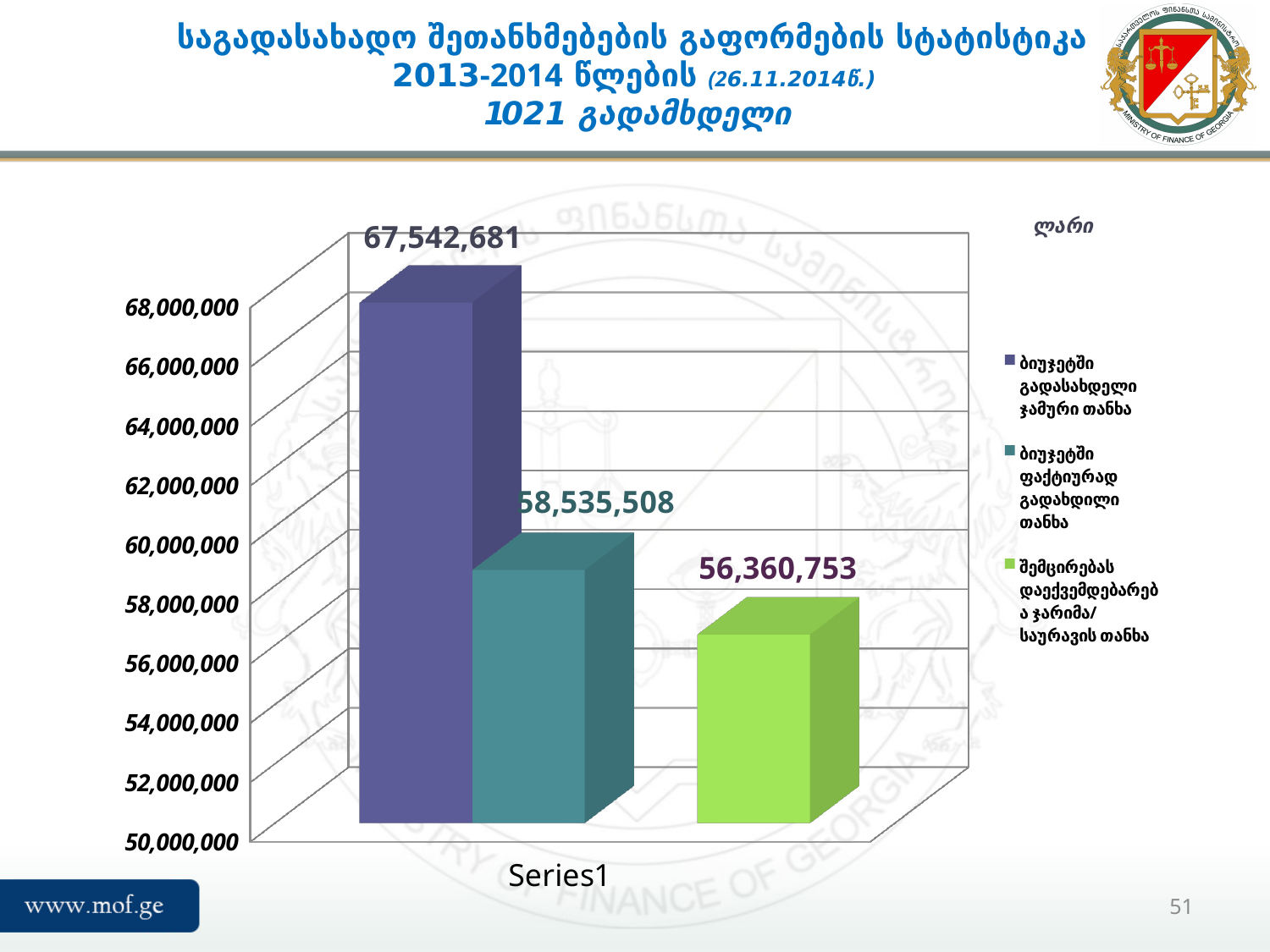
What type of chart is shown on the slide? bar chart What is the value of the bar for ბიუჯეტში გადასახდელი ჯამური თანხა? 67,542,681 What is the value of the bar for ბიუჯეტში ფაქტიურად გადახდილი თანხა? 58,535,508 How many bars are plotted in the chart? 3 How many series does the legend list? 3 Which series has the lowest value in the chart? შემცირებას დაექვემდებარება ჯარიმა/საურავის თანხა Which series has the highest value in the chart? ბიუჯეტში გადასახდელი ჯამური თანხა What is the value of the bar for შემცირებას დაექვემდებარება ჯარიმა/საურავის თანხა? 56,360,753 What is the difference between the value for ბიუჯეტში ფაქტიურად გადახდილი თანხა and the value for შემცირებას დაექვემდებარება ჯარიმა/საურავის თანხა? 2,174,755 What is the label shown on the horizontal axis of the chart? Series1 What is the difference between the value for ბიუჯეტში გადასახდელი ჯამური თანხა and the value for ბიუჯეტში ფაქტიურად გადახდილი თანხა? 9,007,173 Which is larger: the value for ბიუჯეტში ფაქტიურად გადახდილი თანხა or the value for შემცირებას დაექვემდებარება ჯარიმა/საურავის თანხა? ბიუჯეტში ფაქტიურად გადახდილი თანხა